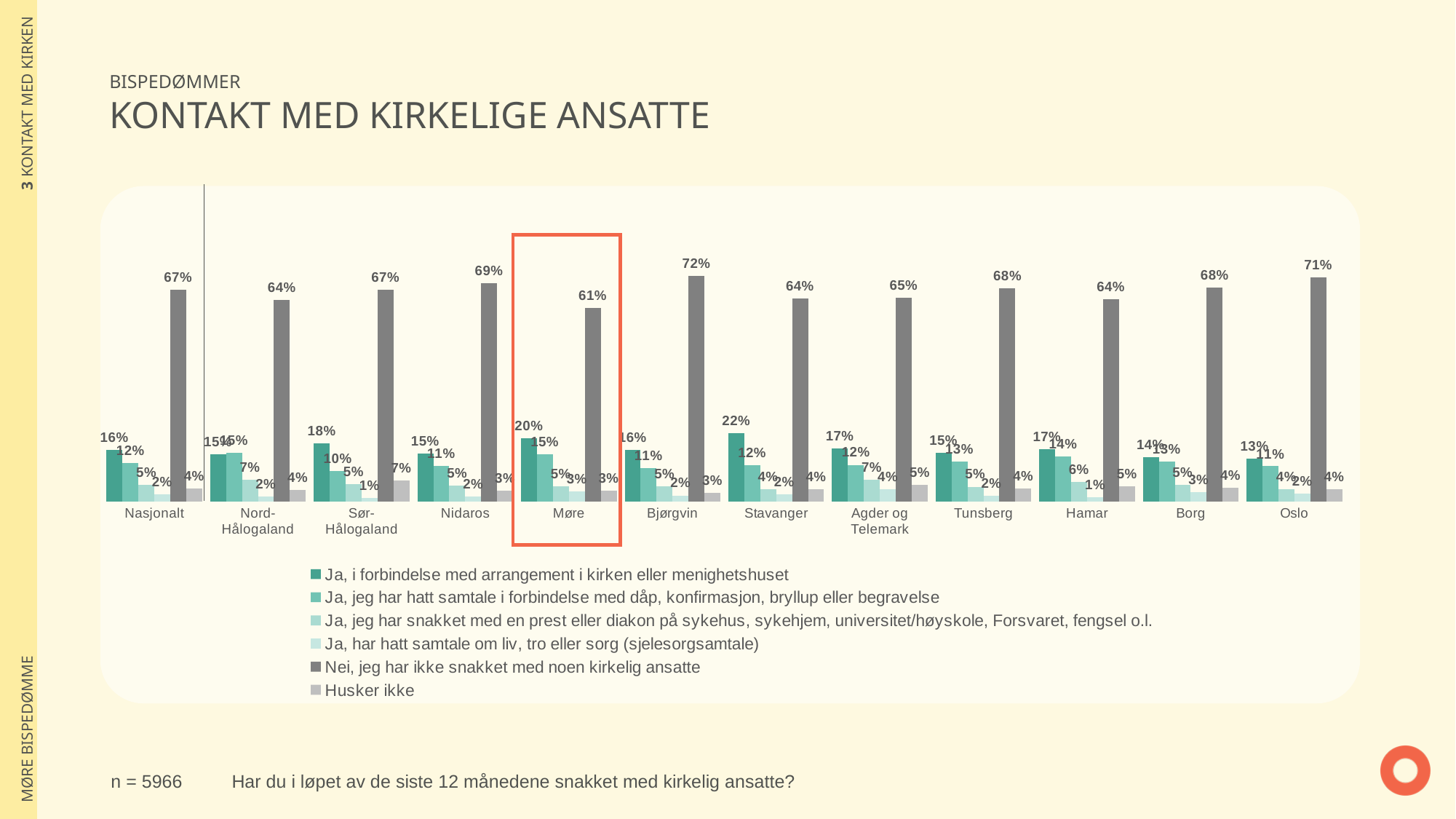
What is the difference between the 'Nei, jeg har ikke snakket med noen kirkelig ansatte' values for Bjørgvin and Møre? 11 percentage points How many categories (bispedømmer, including Nasjonalt) are shown on the x axis? 12 Which category has the lowest value for 'Nei, jeg har ikke snakket med noen kirkelig ansatte'? Møre Which is larger: the 'Ja, i forbindelse med arrangement i kirken eller menighetshuset' value for Stavanger or for Nasjonalt? Stavanger Which category has the highest value for 'Ja, i forbindelse med arrangement i kirken eller menighetshuset'? Stavanger What kind of chart is shown on the slide? Bar chart Which category has the highest value for 'Nei, jeg har ikke snakket med noen kirkelig ansatte'? Bjørgvin Which category is highlighted with a red box on the chart? Møre What is the 'Husker ikke' value for Sør-Hålogaland? 7% What is the value for 'Nei, jeg har ikke snakket med noen kirkelig ansatte' for Oslo? 71% What is the value for 'Ja, i forbindelse med arrangement i kirken eller menighetshuset' for Møre? 20% How many series does the legend list? 6